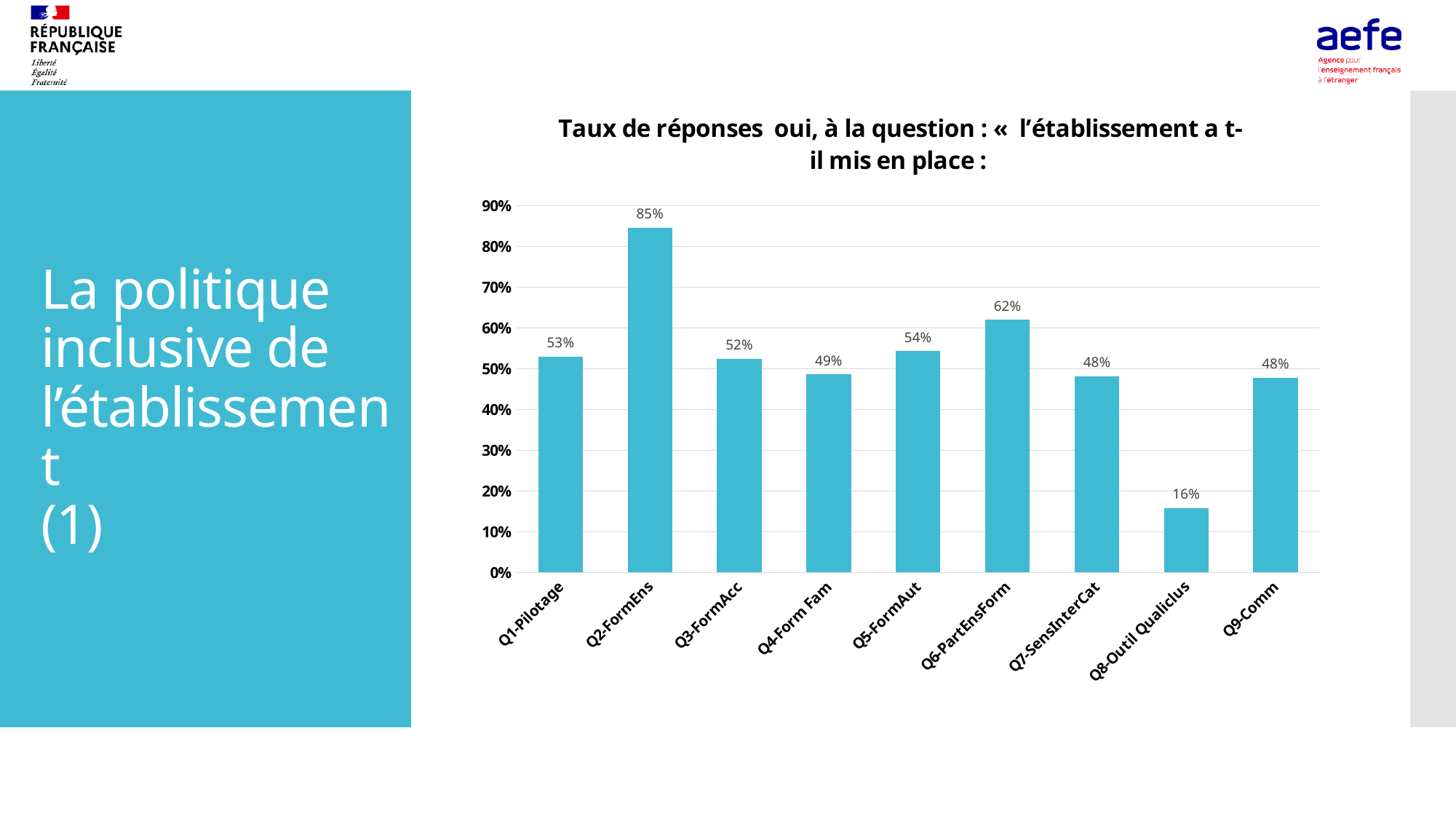
Is the value for Q6-PartEnsForm greater or less than 60%? greater What is the value for Q8-Outil Qualiclus? 16% What is the difference between the values for Q2-FormEns and Q6-PartEnsForm? 23% Which is larger, the value for Q5-FormAut or the value for Q4-Form Fam? Q5-FormAut What colour are the bars in the chart? blue What is the difference between the values for Q1-Pilotage and Q8-Outil Qualiclus? 37% How many categories are shown on the x axis? 9 What kind of chart is shown on the slide? bar chart What is the value for Q6-PartEnsForm? 62% Which category has the highest value? Q2-FormEns Which category has the lowest value? Q8-Outil Qualiclus What is the value for Q2-FormEns? 85%